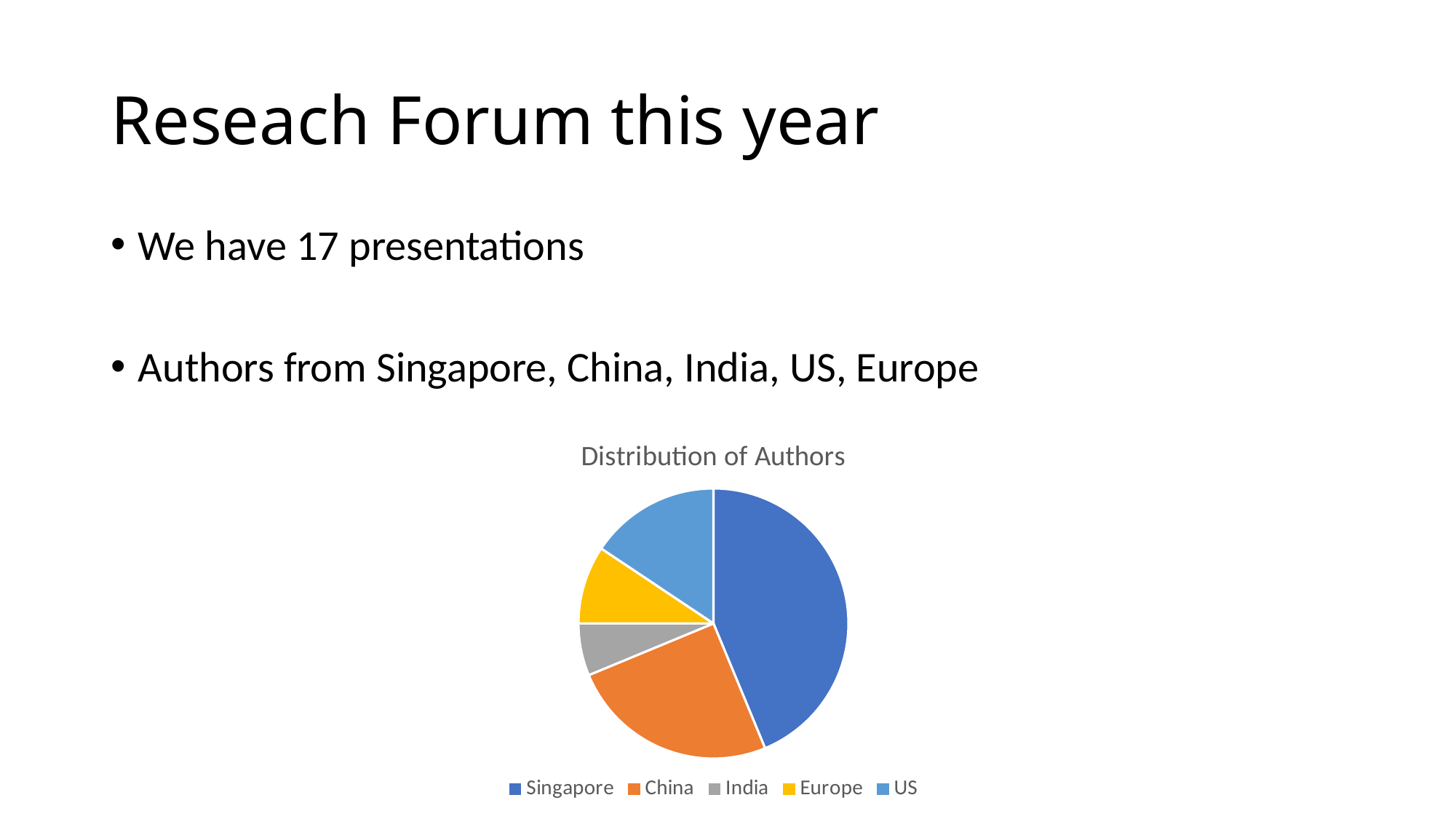
Which slice is larger, Singapore or China? Singapore Which category is shown in orange in the pie chart? China What is the title of the chart? Distribution of Authors Which slice is larger, China or US? China Which category has the smallest slice of the pie? India Which category has the largest slice of the pie? Singapore How many categories does the pie chart have? 5 What kind of chart is shown on the slide? pie chart Which category has the second-largest slice of the pie? China Which slice is larger, China or India? China